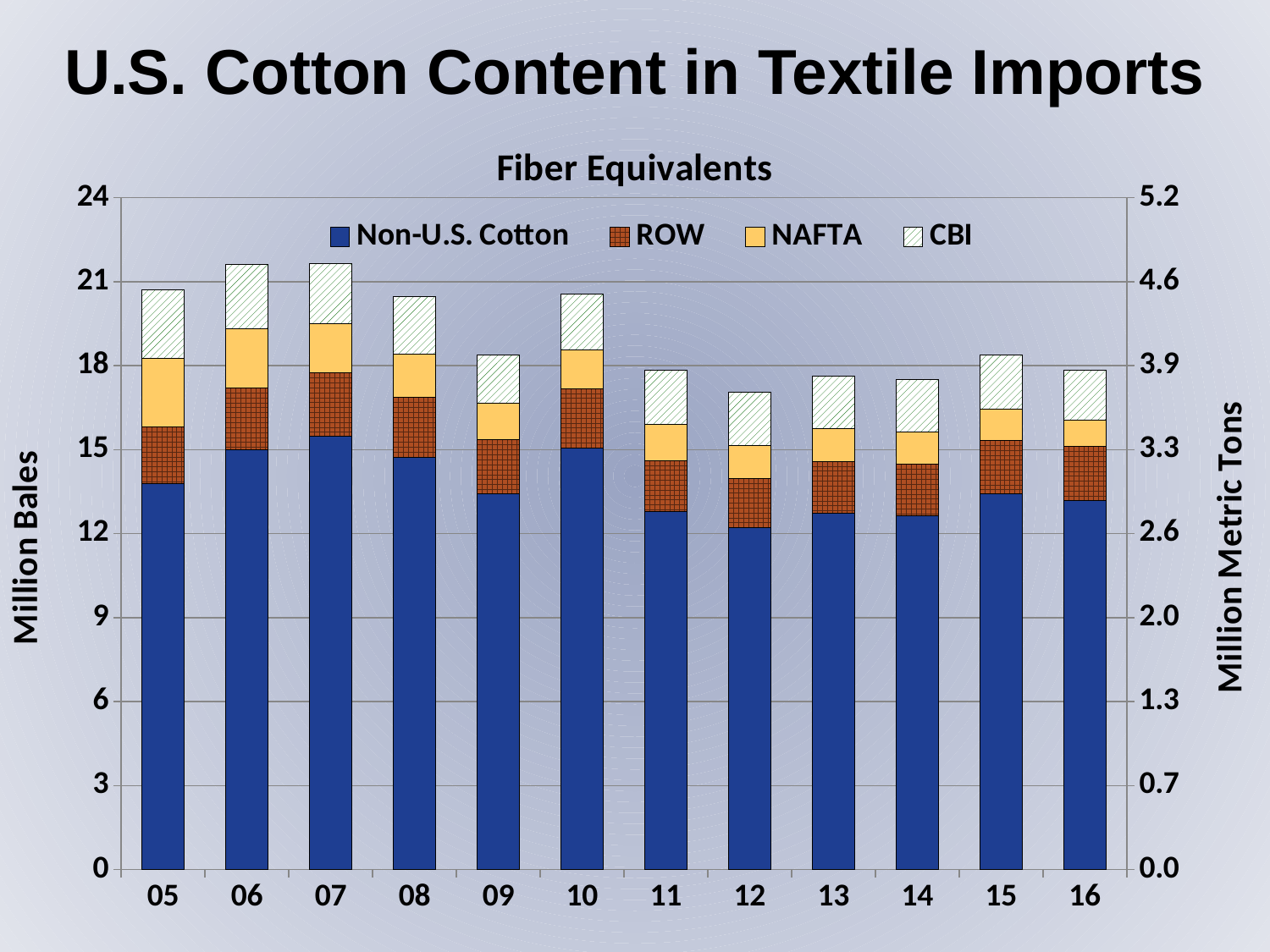
Is the Non-U.S. Cotton value for 11 greater or less than 12 million bales? greater Which year has the lowest total bar height? 12 What is the label of the right vertical axis? Million Metric Tons Is the Non-U.S. Cotton value for 07 greater or less than 15 million bales? greater How many series does the chart's legend list? 4 Is the total bar height for 12 greater or less than 18 million bales? less Which year has the larger total bar, 06 or 12? 06 What is the label of the left vertical axis? Million Bales Do the total bar heights rise or fall from 10 to 12? fall How many years are shown along the x axis of the chart? 12 What kind of chart is shown on the slide? Stacked bar chart